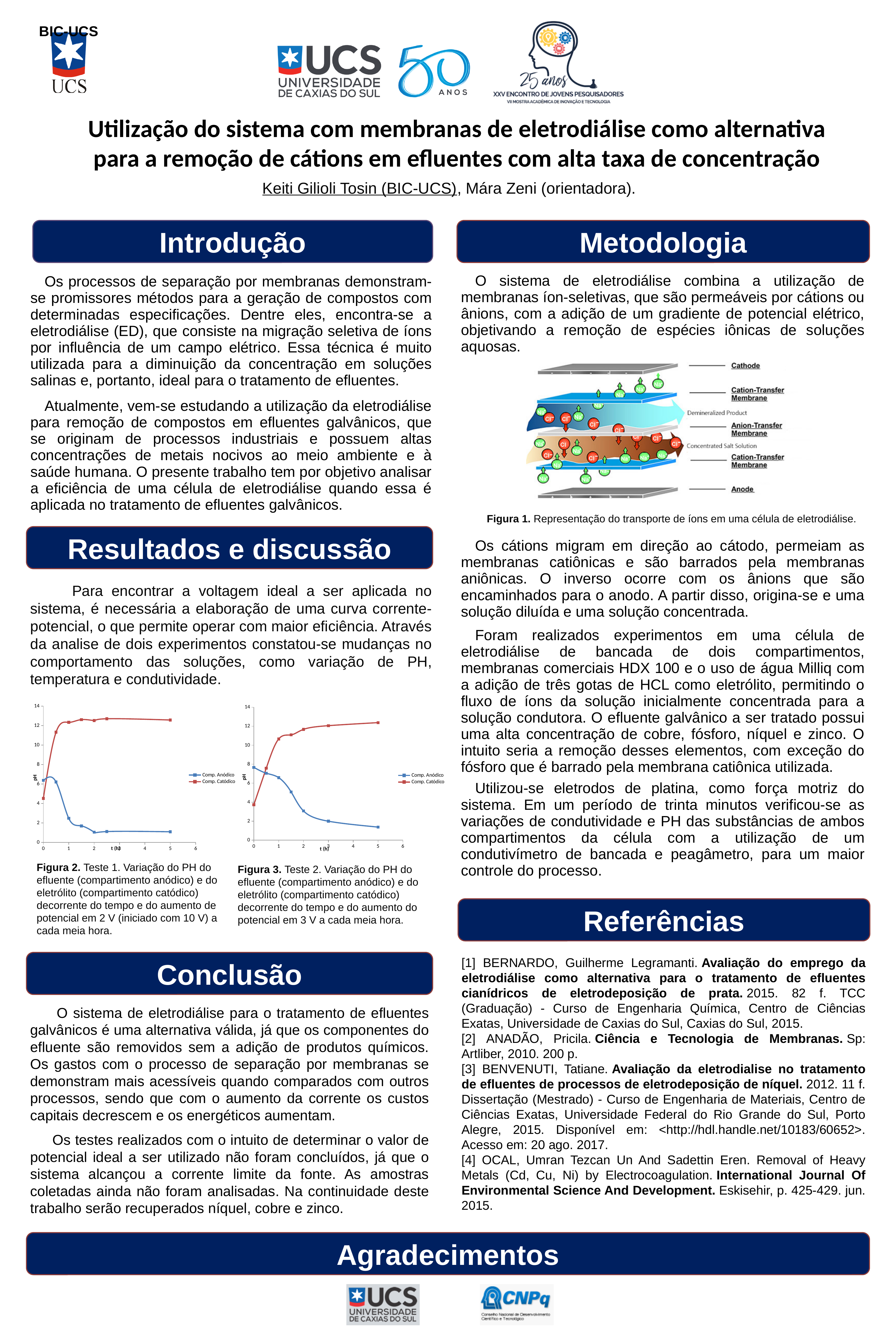
How many series does the legend of Figura 2 list? 2 In Figura 2, does the Comp. Catódico series rise or fall along the x axis? rise In Figura 3, which series has the higher value at t = 5 h, Comp. Anódico or Comp. Catódico? Comp. Catódico In Figura 3, is the value for Comp. Catódico at t = 5 h greater or less than 10? greater In Figura 2, does the Comp. Anódico series rise or fall along the x axis? fall What kind of chart is Figura 3 (the right chart)? line chart What kind of chart is Figura 2 (the left chart)? line chart In Figura 3, is the value for Comp. Anódico at t = 0 h greater or less than 6? greater In Figura 2, is the value for Comp. Anódico at t = 5 h greater or less than 2? less What is the label of the y axis in Figura 2? pH In Figura 3, does the Comp. Anódico series rise or fall along the x axis? fall